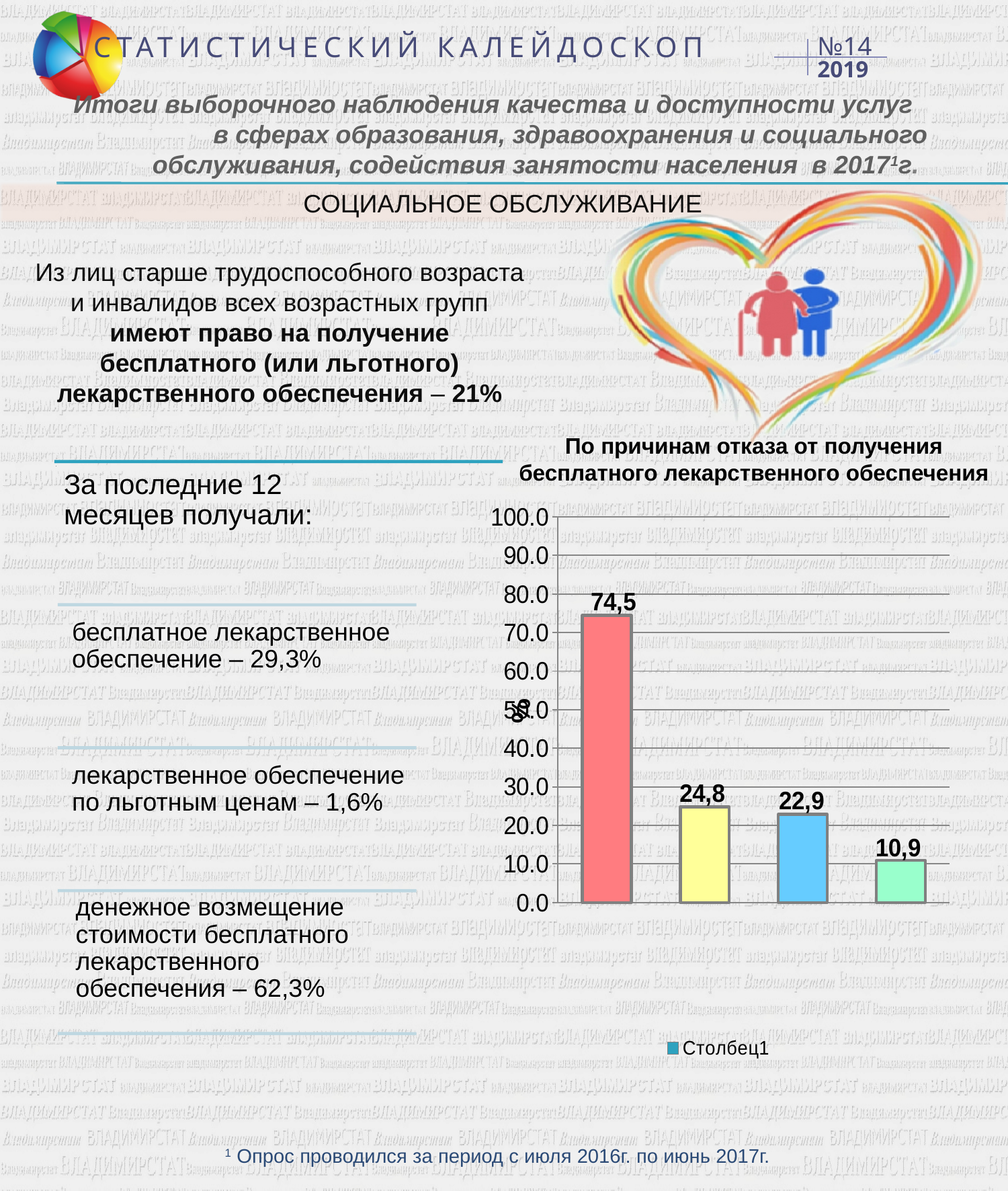
How many bars does the chart contain? 4 What is the legend entry shown below the chart? Столбец1 How many series does the chart legend list? 1 What is the difference between the first bar (74,5) and the second bar (24,8)? 49,7 What kind of chart is shown on the slide? bar chart Which is larger: the value of the yellow bar or the value of the blue bar? the yellow bar (24,8) Is the value of the red bar greater or less than 70.0? greater What is the value shown on the tallest bar of the chart? 74,5 What value is printed on the second bar from the left (the yellow bar)? 24,8 What value is printed on the blue bar (third from the left)? 22,9 What is the value shown on the shortest bar of the chart? 10,9 Do the bar values rise or fall from left to right across the chart? fall